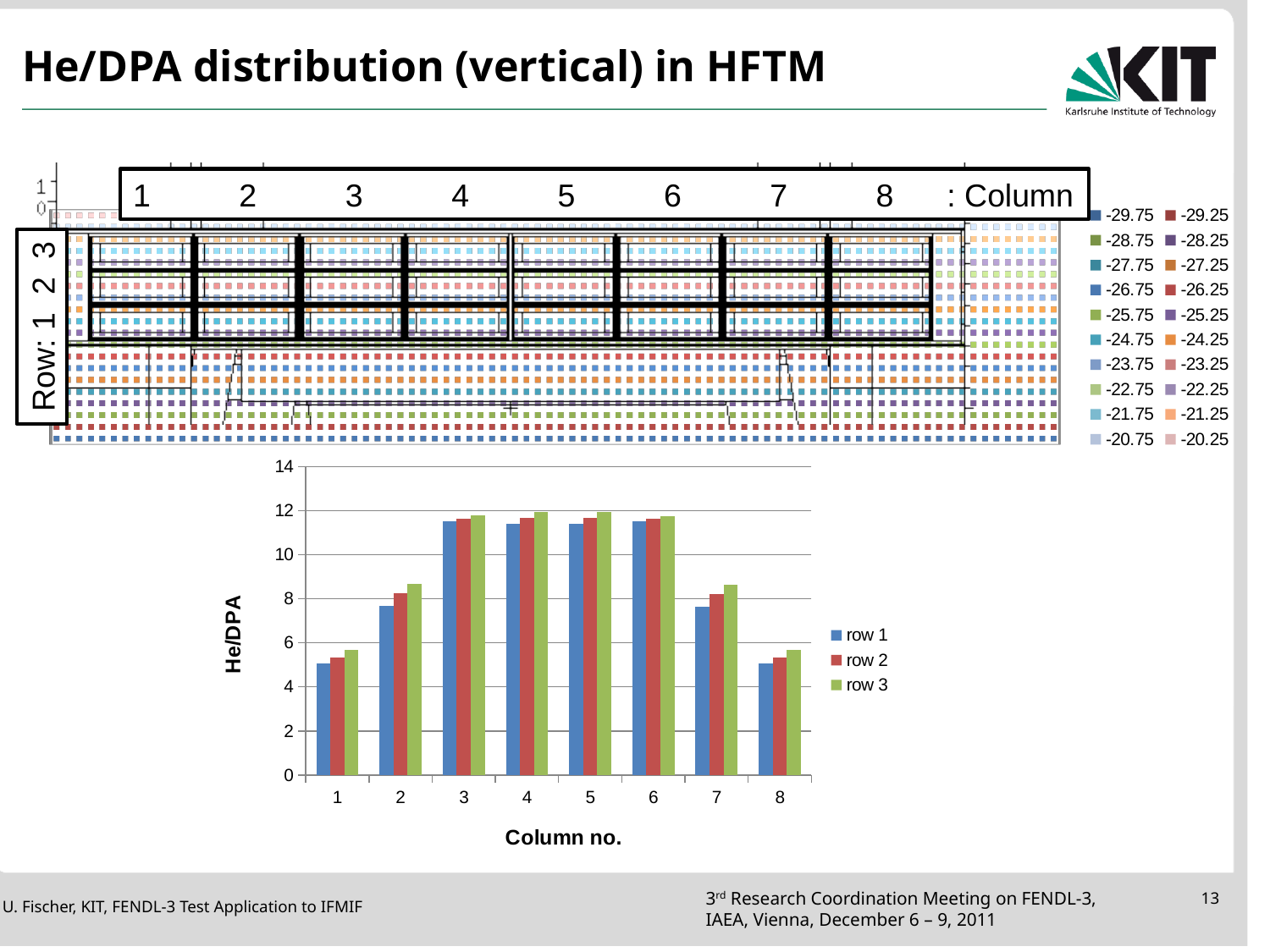
In the He/DPA bar chart, which series has the lowest value at column 2? row 1 In the He/DPA bar chart, is the value for row 2 at column 2 greater or less than 10? less How many column numbers are shown on the x axis of the He/DPA bar chart? 8 In the He/DPA bar chart, which is larger at column 8: row 1 or row 3? row 3 What kind of chart is shown at the bottom of the slide? bar chart In the He/DPA bar chart, is the value for row 1 at column 7 greater or less than 6? greater In the He/DPA bar chart, do the row 1 values rise or fall from column 6 to column 8? fall In the He/DPA bar chart, is the value for row 3 at column 4 greater or less than 10? greater In the He/DPA bar chart, which is larger for row 1: the value at column 2 or the value at column 3? column 3 How many series does the legend of the He/DPA bar chart list? 3 What is the label of the y axis of the bar chart? He/DPA